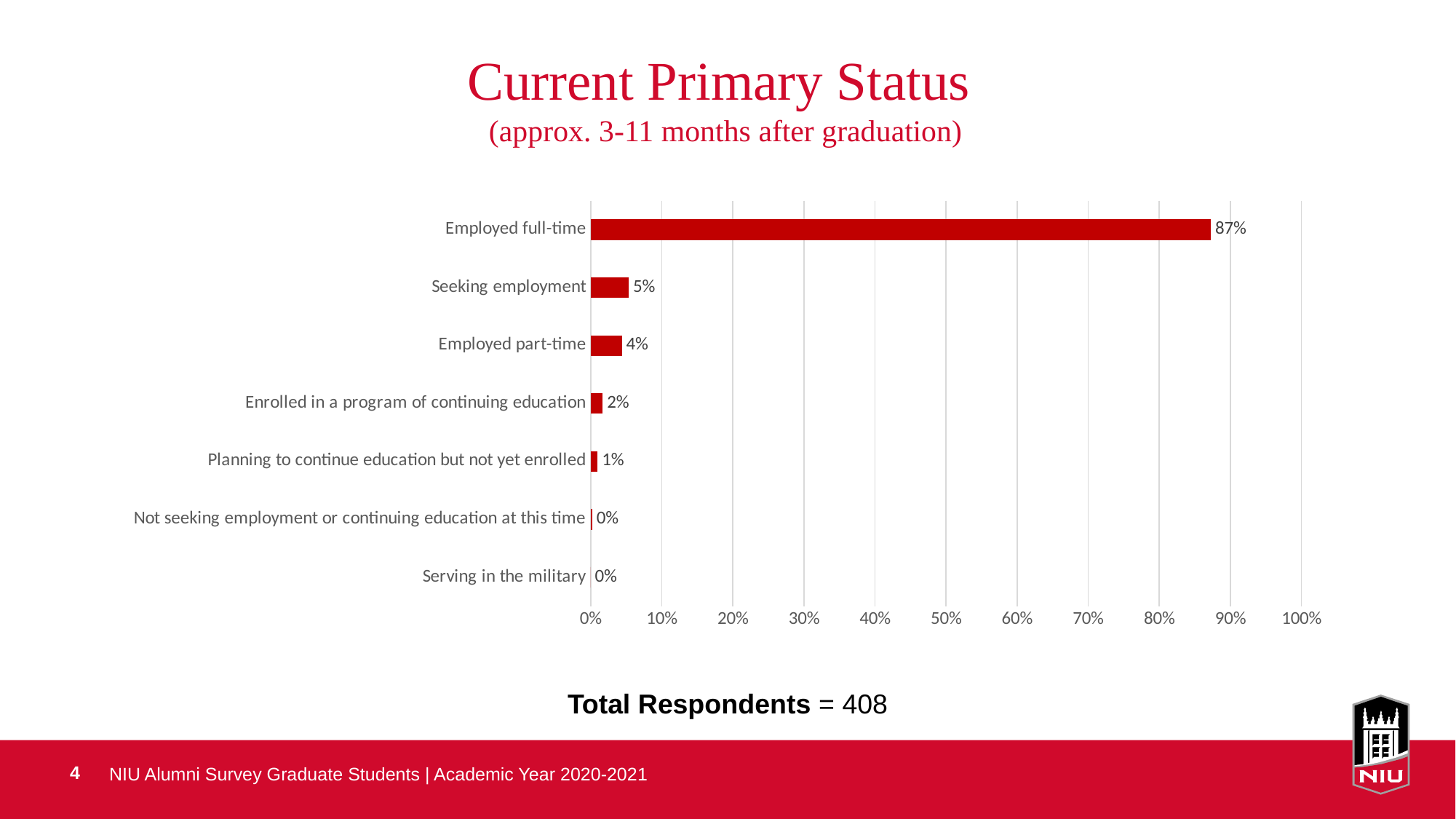
What is the difference between Seeking employment and Employed part-time? 1% What percentage of respondents are enrolled in a program of continuing education? 2% What kind of chart is shown on the slide? Bar chart How many categories are shown in the chart? 7 Is the value for Employed full-time greater or less than 80%? greater Which category has the highest value? Employed full-time What is the value for Seeking employment? 5% What is the total number of respondents stated on the slide? 408 What is the value for Planning to continue education but not yet enrolled? 1% What is the difference between Employed full-time and Seeking employment? 82% What percentage of respondents are employed full-time? 87% Which is larger, Employed part-time or Enrolled in a program of continuing education? Employed part-time